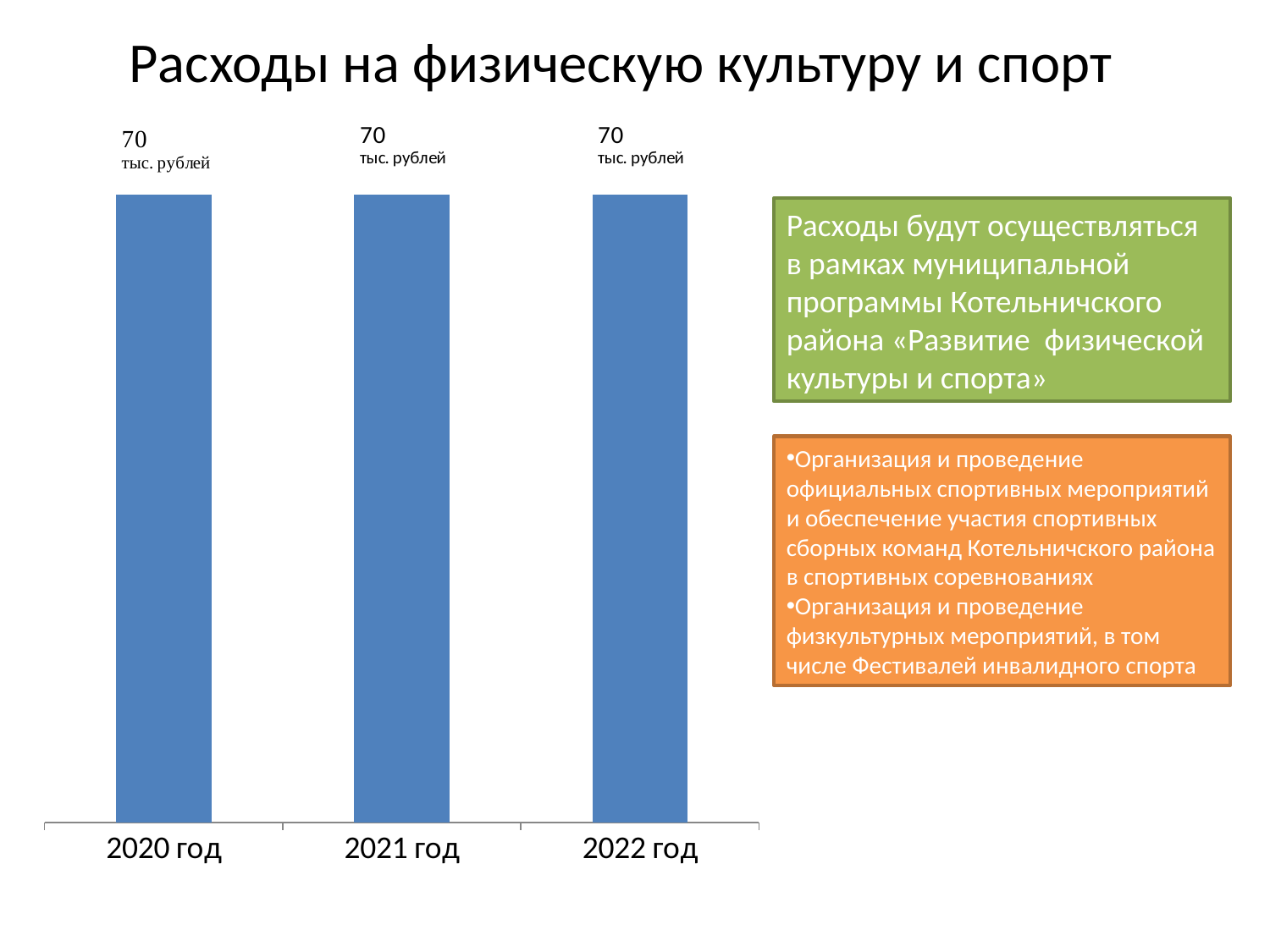
What is the title of the slide containing the chart? Расходы на физическую культуру и спорт What is the difference between the values for 2022 год and 2020 год? 0 Do the values rise, fall, or stay the same from 2020 год to 2022 год? stay the same What is the value for 2022 год? 70 тыс. рублей What is the value for 2021 год? 70 тыс. рублей What is the value for 2020 год? 70 тыс. рублей What kind of chart is shown on the slide? bar chart What unit are the data labels on the chart expressed in? тыс. рублей How many categories (years) are shown on the chart? 3 Is the value for 2021 год larger than, smaller than, or equal to the value for 2020 год? equal What is the total of the values for all three years shown? 210 тыс. рублей